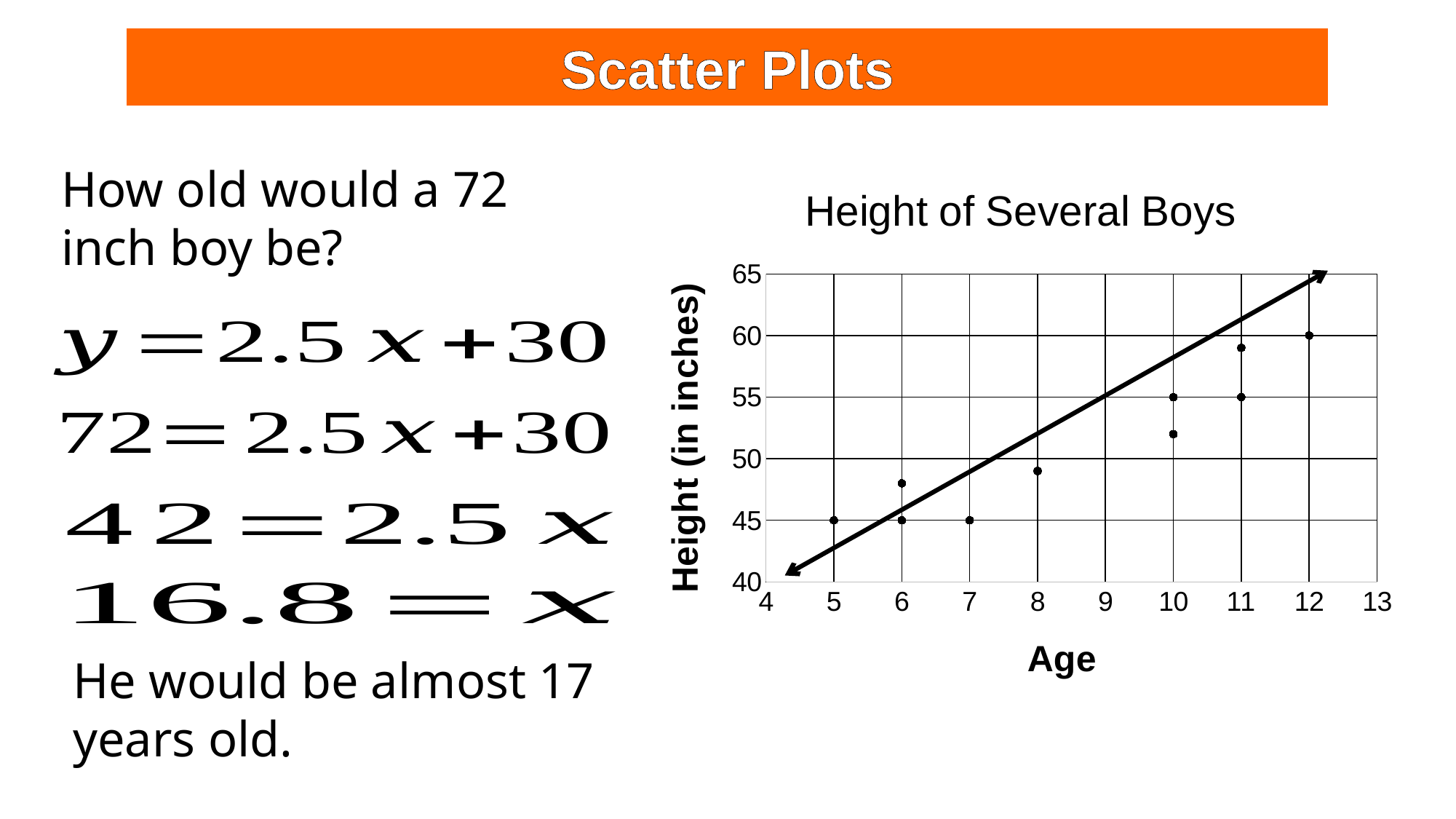
What is the height of the boy aged 5? 45 What is the title of the chart? Height of Several Boys Is the height for the boy aged 7 greater or less than 50? less Which is taller, the boy aged 8 or the boy aged 5? The boy aged 8 Do the heights generally rise or fall as age increases along the x axis? Rise What is the label of the vertical axis of the chart? Height (in inches) What is the height of the boy aged 12? 60 Is the height for the boy aged 8 greater or less than 50? less How many data points are plotted on the chart? 10 Which age has the tallest boy on the chart? 12 Is the height of the taller boy aged 11 greater or less than 55? greater What kind of chart is shown on the slide? Scatter plot